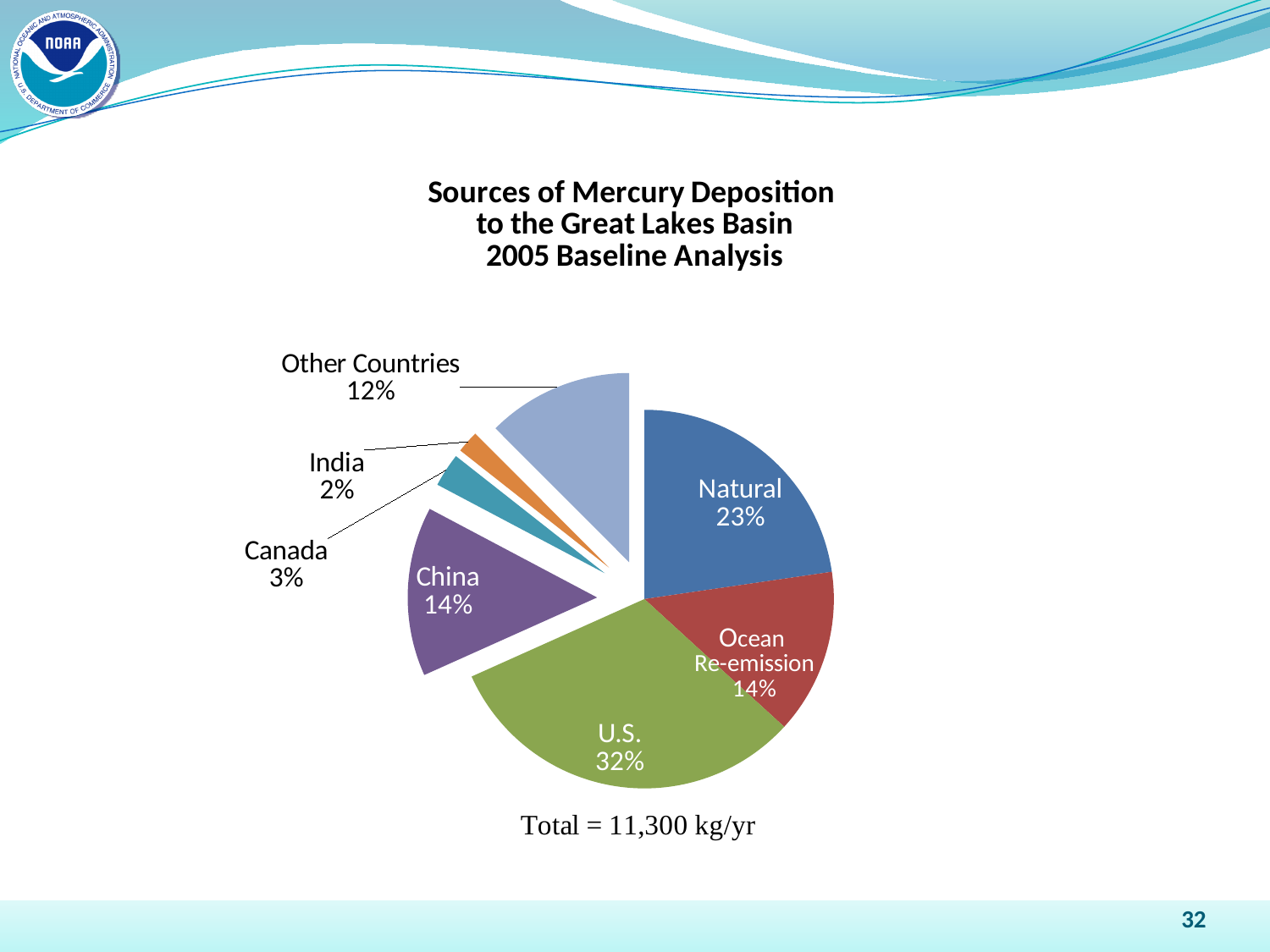
How many percentage points larger is the U.S. share than the Natural share? 9 What percentage of the pie is attributed to Natural sources? 23% How many slices does the pie chart have? 7 What share does China contribute according to the pie chart? 14% Which source has the largest slice of the pie? U.S. What share of mercury deposition to the Great Lakes Basin comes from the U.S.? 32% What percentage is shown for Other Countries? 12% What type of chart is shown on the slide? Pie chart Which source has the smallest slice of the pie? India Which is larger, the share for Canada or the share for India? Canada What total value is stated below the pie chart? 11,300 kg/yr What percentage is shown for India? 2%